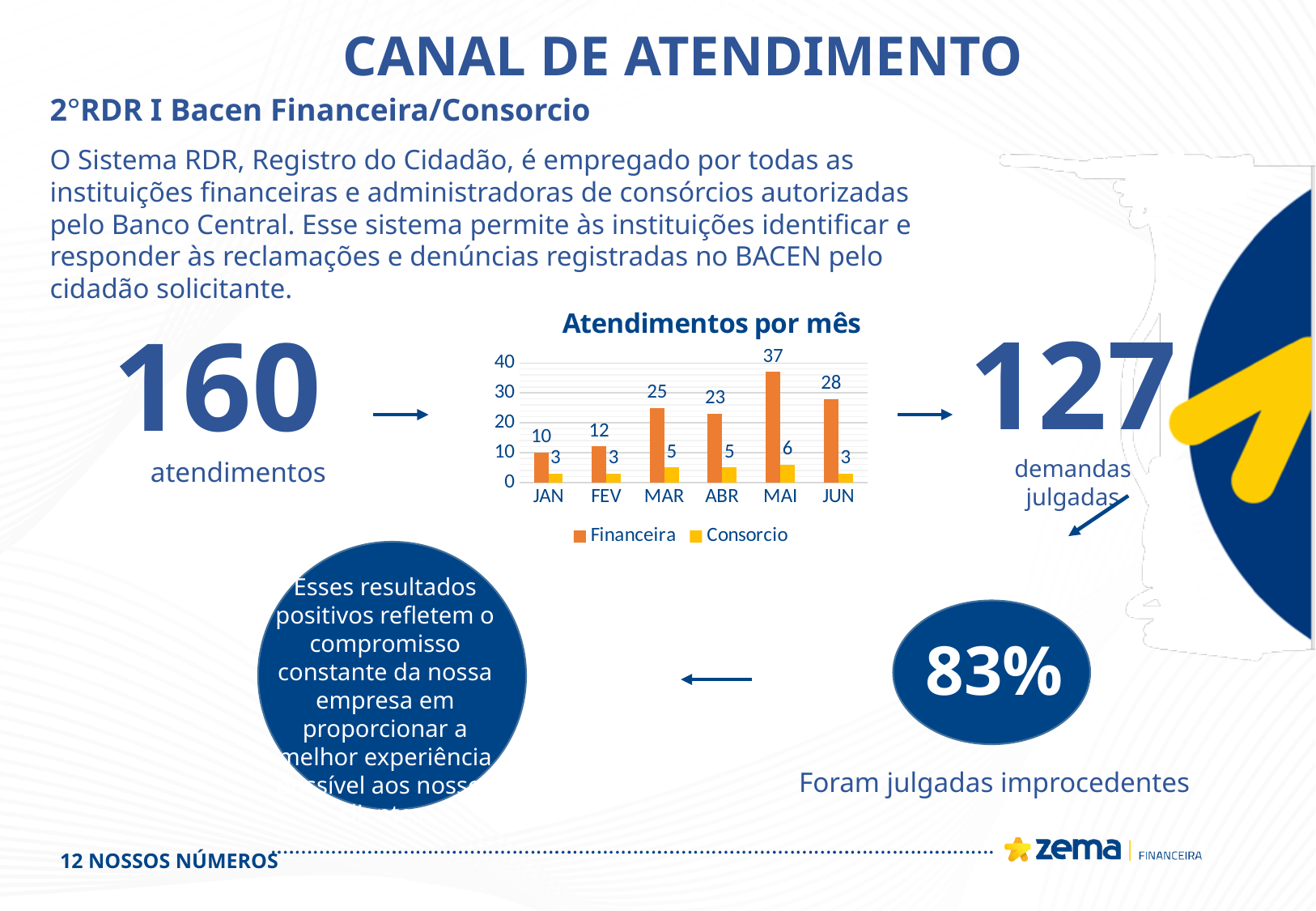
What is the Consorcio value for MAR? 5 How many series does the chart's legend list? 2 How many months are shown on the x axis of the chart? 6 What type of chart is shown on the slide? bar chart Which is larger, the Financeira value for MAR or for ABR? MAR What is the title of the chart on the slide? Atendimentos por mês Which series is shown in orange in the chart? Financeira Which month has the lowest Financeira value? JAN Which month has the highest Financeira value? MAI What is the Financeira value for MAI? 37 What is the total of Financeira and Consorcio for FEV? 15 What is the difference between the Financeira values for MAI and JUN? 9